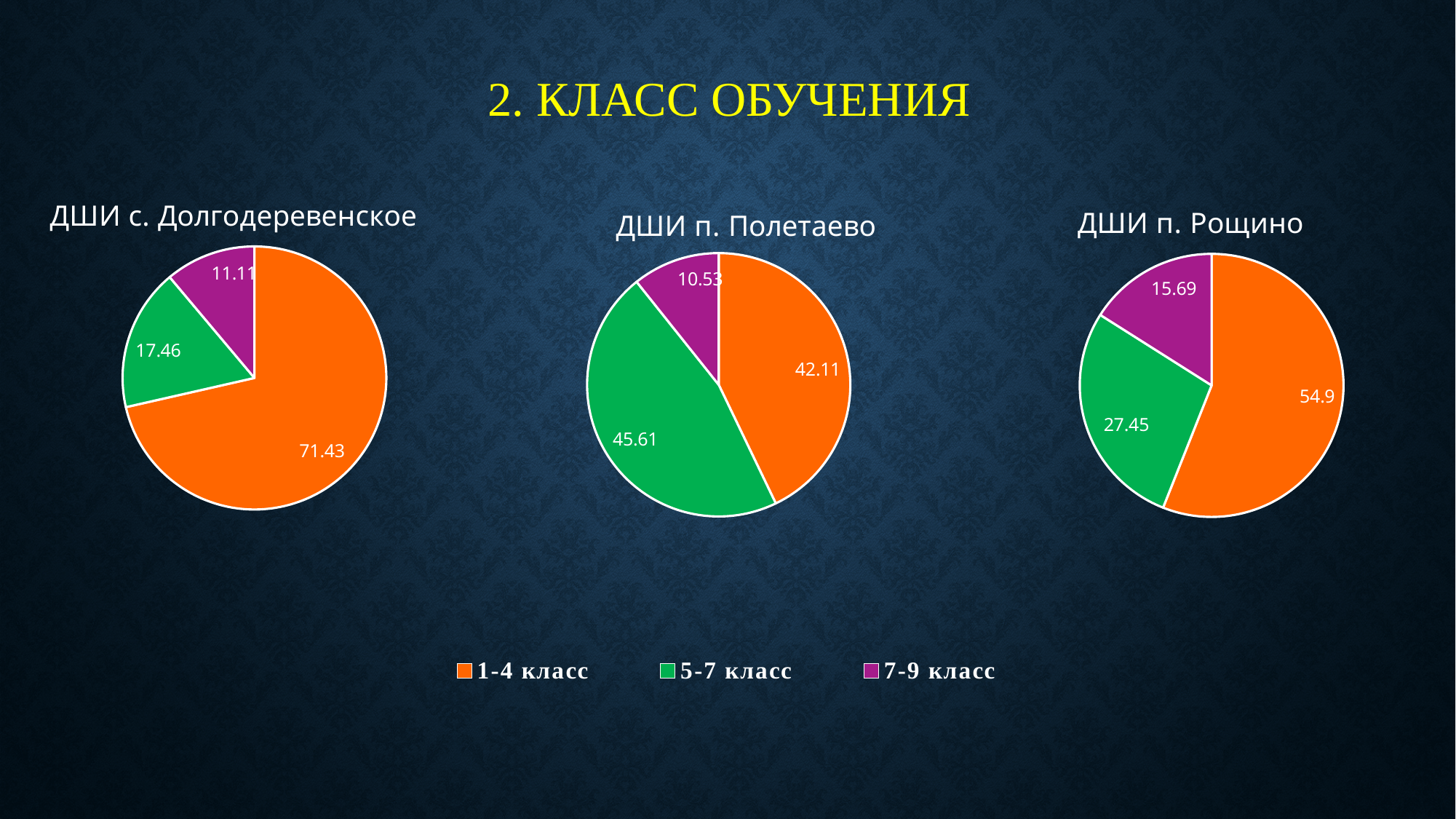
In the chart titled "ДШИ п. Рощино", what is the value for 7-9 класс? 15.69 In the chart titled "ДШИ с. Долгодеревенское", which category has the smallest slice? 7-9 класс What kind of chart is the chart titled "ДШИ п. Рощино"? pie chart In the chart titled "ДШИ п. Рощино", which is larger: the value for 5-7 класс or the value for 7-9 класс? 5-7 класс In the chart titled "ДШИ п. Полетаево", what is the difference between the values for 5-7 класс and 1-4 класс? 3.5 How many slices does the chart titled "ДШИ п. Полетаево" have? 3 In the chart titled "ДШИ п. Полетаево", which category has the largest slice? 5-7 класс How many entries does the shared legend list? 3 In the chart titled "ДШИ п. Рощино", which category has the largest slice? 1-4 класс In the chart titled "ДШИ п. Полетаево", what is the value for 5-7 класс? 45.61 In the chart titled "ДШИ с. Долгодеревенское", what is the value for 1-4 класс? 71.43 In the chart titled "ДШИ с. Долгодеревенское", what is the difference between the values for 1-4 класс and 5-7 класс? 53.97